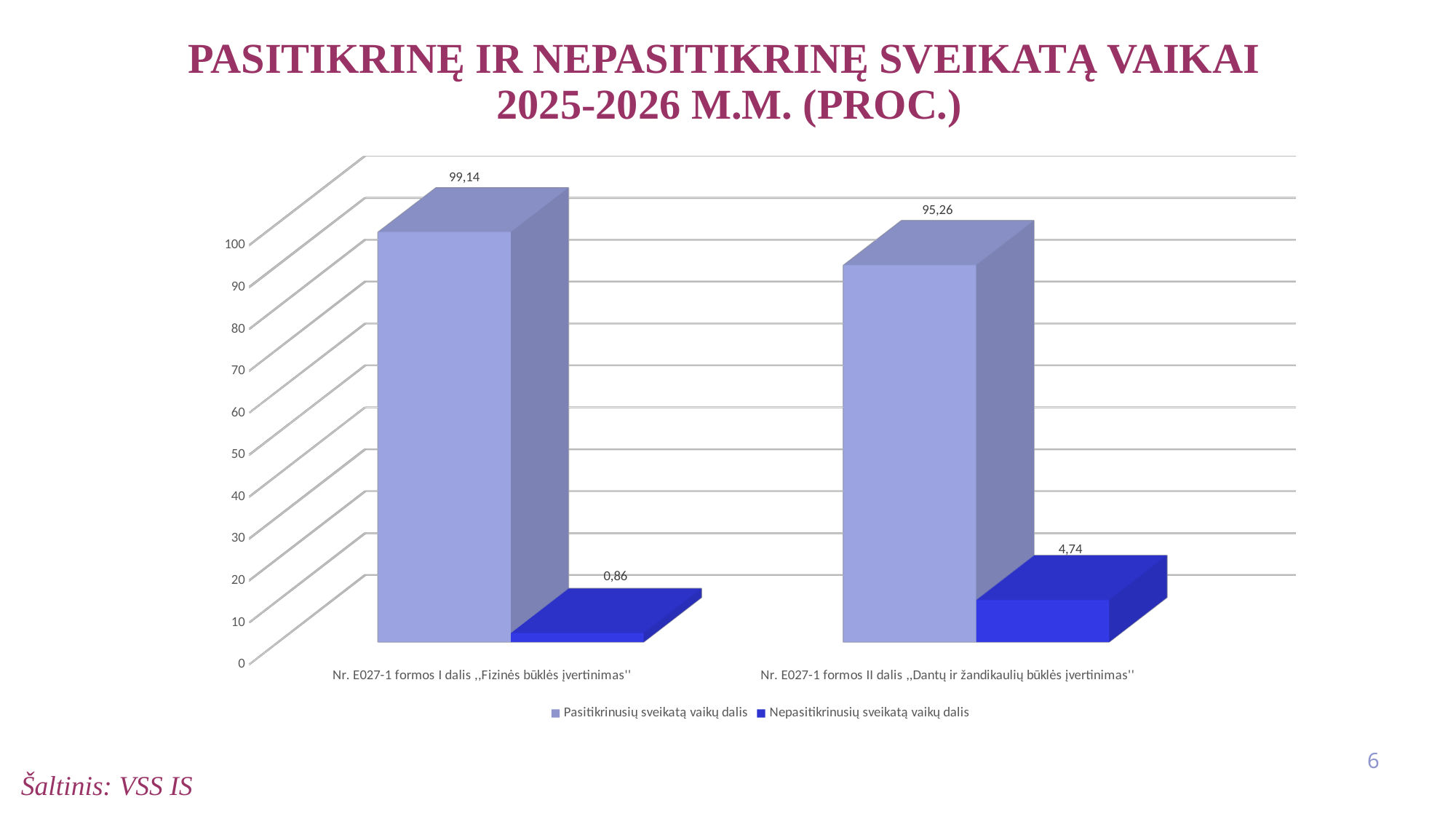
What is the value of "Pasitikrinusių sveikatą vaikų dalis" for "Nr. E027-1 formos I dalis ,,Fizinės būklės įvertinimas''"? 99,14 How many categories are shown on the x axis? 2 How many series does the legend list? 2 What kind of chart is shown on the slide? bar chart Is the "Nepasitikrinusių sveikatą vaikų dalis" value for "Nr. E027-1 formos II dalis" larger or smaller than the one for "Nr. E027-1 formos I dalis"? larger Which category has the higher value for "Pasitikrinusių sveikatą vaikų dalis"? Nr. E027-1 formos I dalis ,,Fizinės būklės įvertinimas'' Which category has the lowest value for "Nepasitikrinusių sveikatą vaikų dalis"? Nr. E027-1 formos I dalis ,,Fizinės būklės įvertinimas'' Is the value of "Pasitikrinusių sveikatą vaikų dalis" for "Nr. E027-1 formos II dalis" greater or less than 90? greater What is the value of "Nepasitikrinusių sveikatą vaikų dalis" for "Nr. E027-1 formos II dalis ,,Dantų ir žandikaulių būklės įvertinimas''"? 4,74 What is the difference between the "Pasitikrinusių sveikatą vaikų dalis" values for the two categories? 3,88 What is the value of "Nepasitikrinusių sveikatą vaikų dalis" for "Nr. E027-1 formos I dalis ,,Fizinės būklės įvertinimas''"? 0,86 What is the value of "Pasitikrinusių sveikatą vaikų dalis" for "Nr. E027-1 formos II dalis ,,Dantų ir žandikaulių būklės įvertinimas''"? 95,26